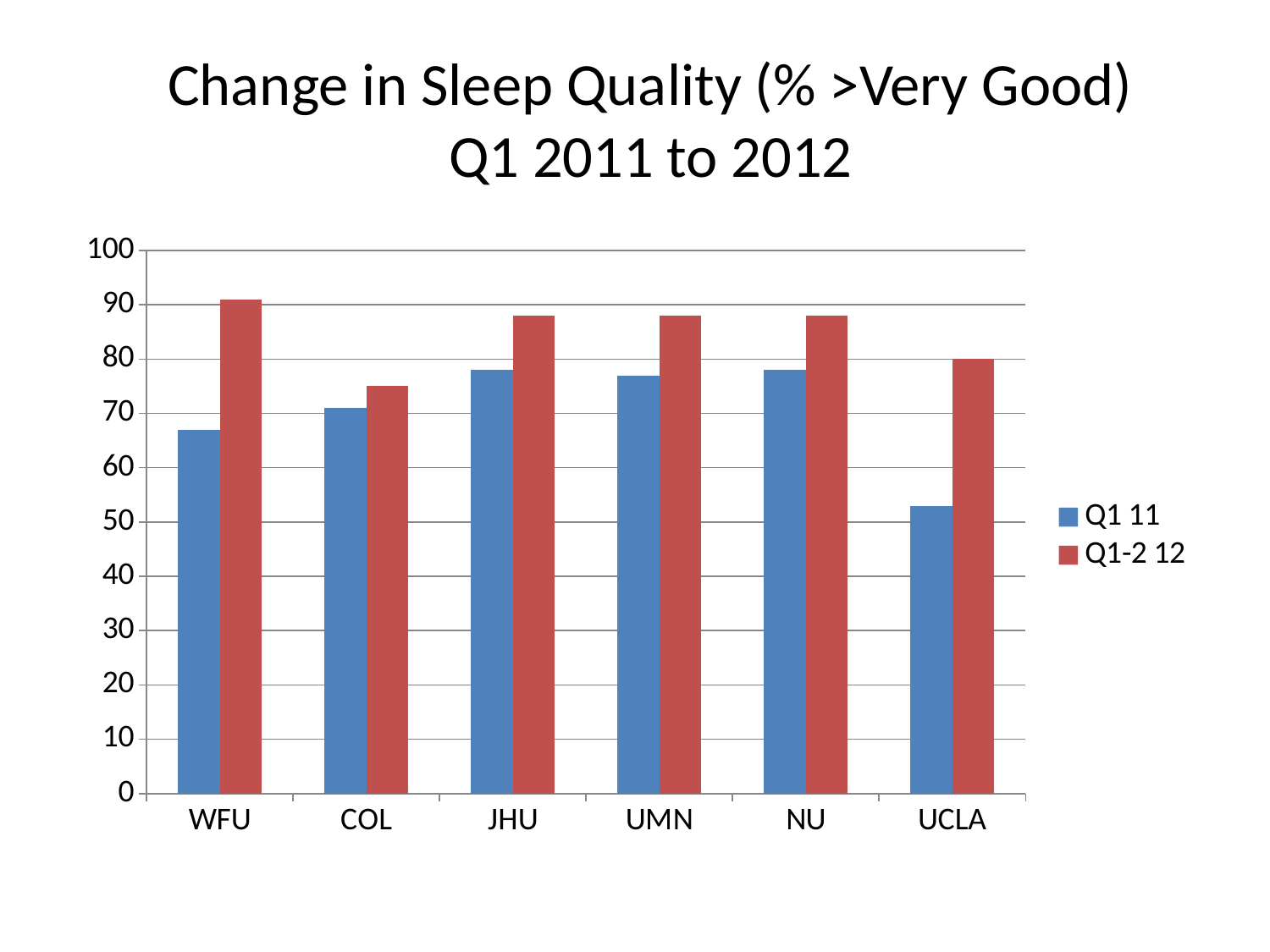
Which is larger, the Q1 11 value for COL or the Q1 11 value for WFU? COL How many universities are shown on the x axis of the chart? 6 How many series does the chart's legend list? 2 Which university has the lowest Q1 11 value? UCLA What kind of chart is shown on the slide? bar chart For each university, is the Q1-2 12 bar higher or lower than the Q1 11 bar? higher Is the Q1 11 value for UCLA greater or less than 60? less What is the title of the chart? Change in Sleep Quality (% >Very Good) Q1 2011 to 2012 Is the Q1 11 value for WFU greater or less than 70? less Is the Q1-2 12 value for COL greater or less than 80? less Which university has the highest Q1-2 12 value? WFU